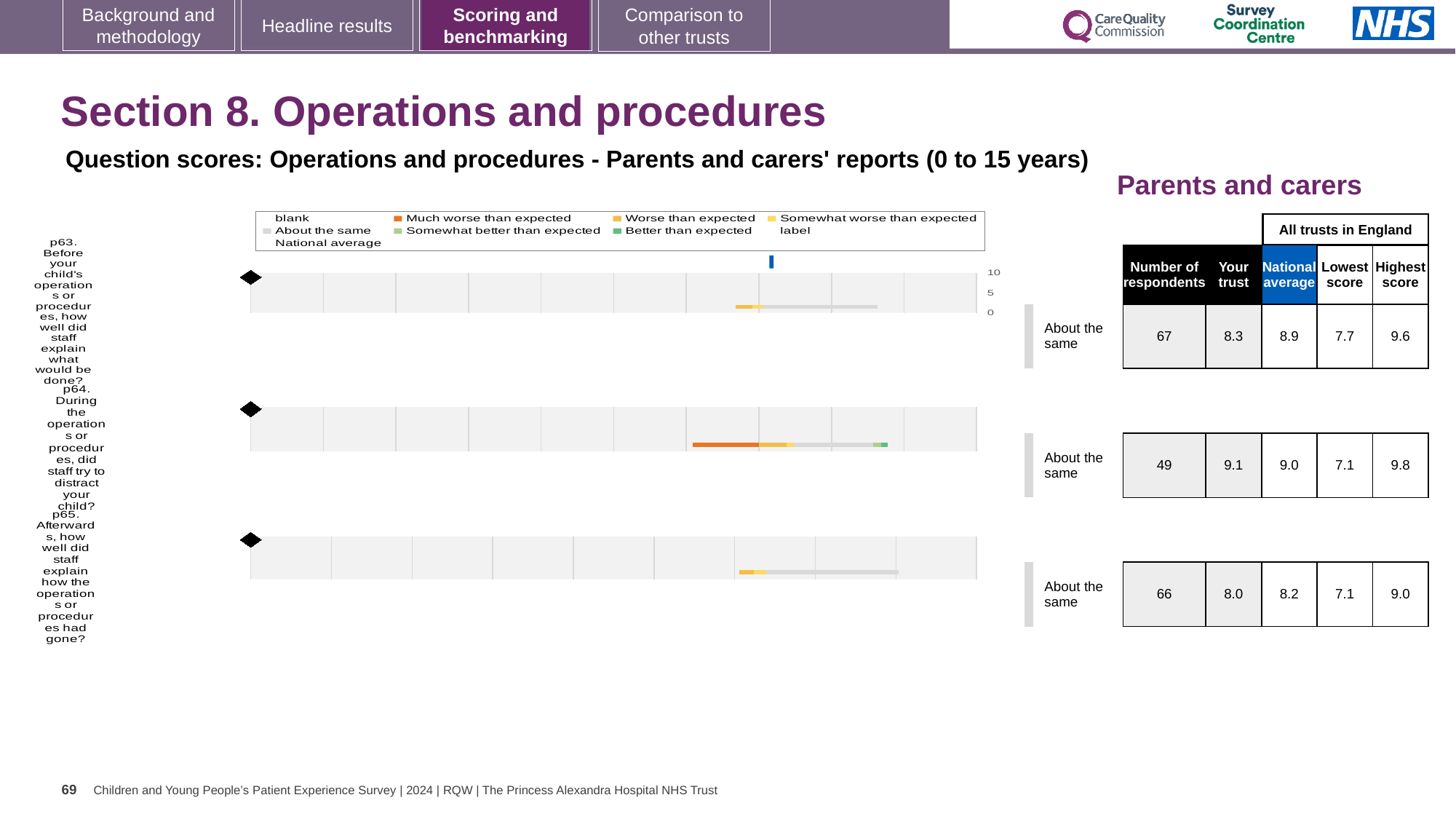
For question p64, what is the difference between the highest score and the lowest score across all trusts in England? 2.7 What is the lowest score across all trusts in England for question p63? 7.7 For question p65, how much higher is the national average than the 'Your trust' score? 0.2 How many questions are plotted on this slide? 3 What is the national average score for question p64 (During the operations or procedures, did staff try to distract your child?)? 9.0 What benchmarking category is shown for question p64? About the same Which of the three questions has the lowest 'Your trust' score? p65 Which of the three questions has the highest 'Your trust' score? p64 What is the 'Your trust' score for question p63 (Before your child's operations or procedures, how well did staff explain what would be done?)? 8.3 For question p63, which is larger: the 'Your trust' score or the national average? National average What kind of chart is used to show the question scores on this slide? Bar chart How many respondents answered question p65 (Afterwards, how well did staff explain how the operations or procedures had gone?)? 66